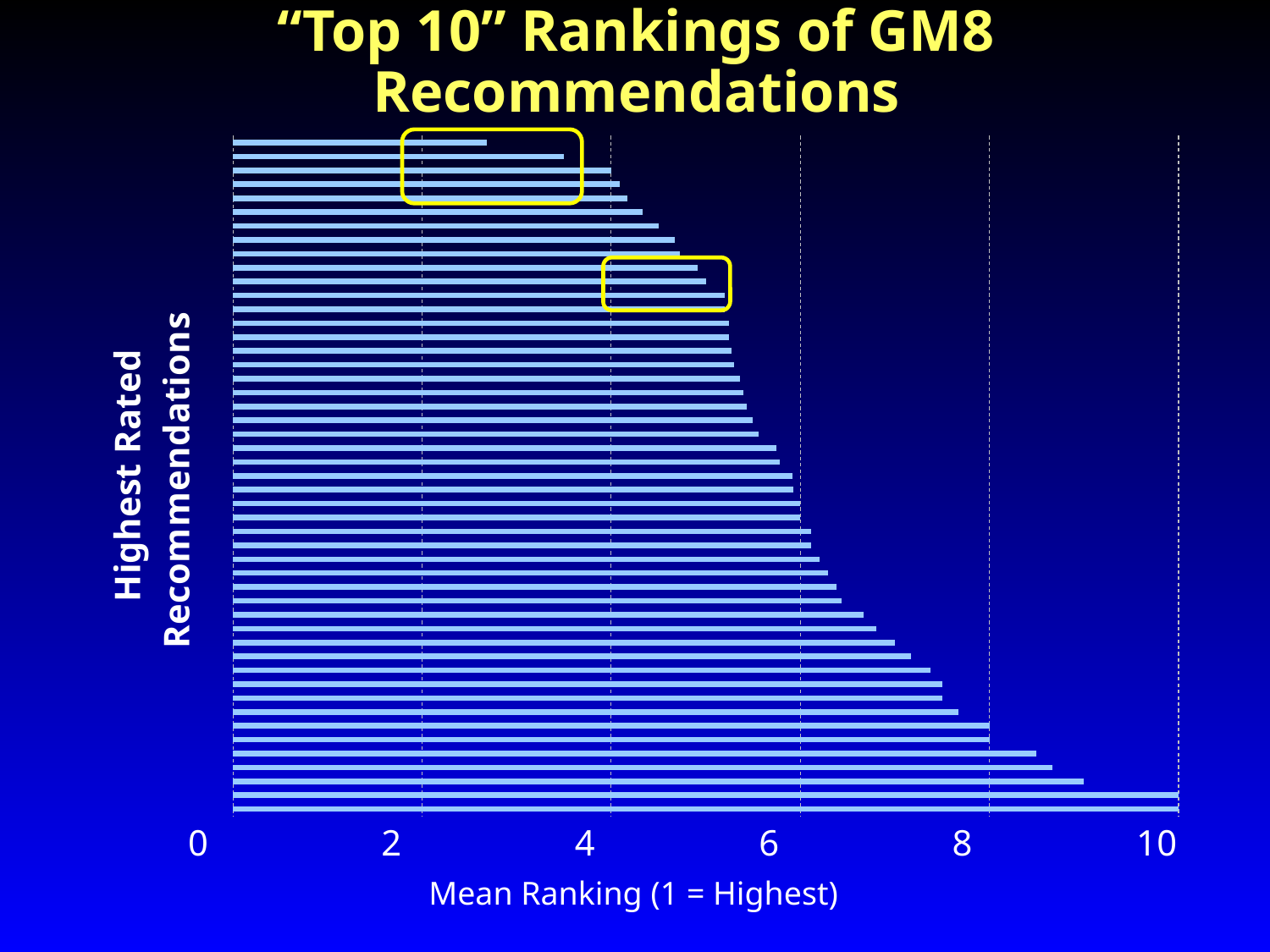
What kind of chart is shown on the slide? bar chart What is the title of the chart? "Top 10" Rankings of GM8 Recommendations Which bar is longer: the topmost bar or the bottommost bar? the bottommost bar Is the value of the longest bar (at the bottom of the chart) greater or less than 8? greater Do the bar lengths increase or decrease going from the top of the chart to the bottom? increase What is the highest value shown on the horizontal axis? 10 Is the value of the shortest bar (at the top of the chart) greater or less than 4? less What is the label on the horizontal axis of the chart? Mean Ranking (1 = Highest) Is the value of the shortest bar (at the top of the chart) greater or less than 2? greater